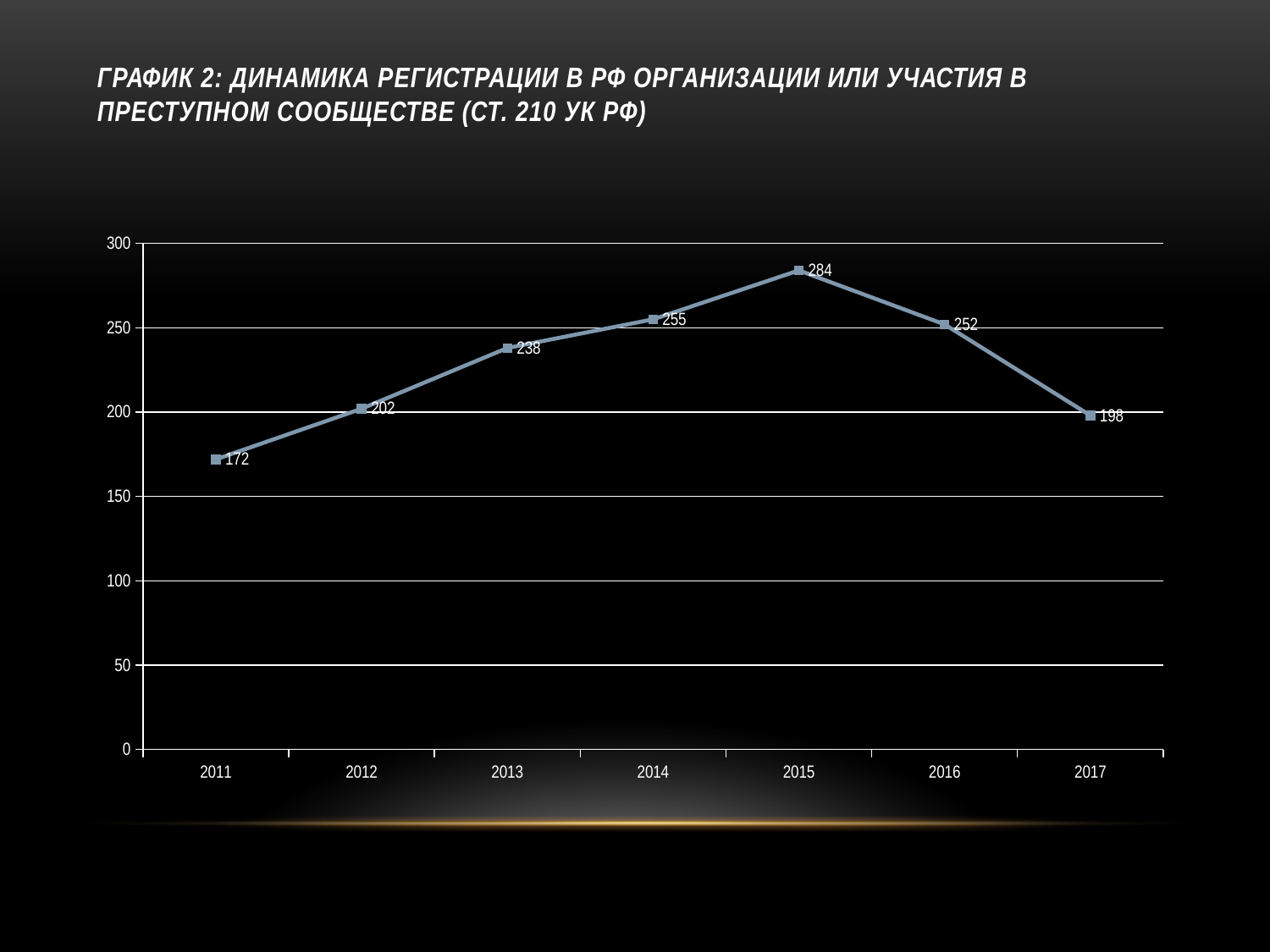
What is the difference between the values for 2013 and 2012? 36 What kind of chart is shown on the slide? line chart Is the value for 2017 greater or less than 200? less Which year has the highest value? 2015 What is the value for 2015? 284 What is the difference between the values for 2015 and 2016? 32 What is the value for 2017? 198 Do the values rise or fall from 2011 to 2015? rise How many years are plotted on the chart? 7 Which is larger, the value for 2014 or the value for 2016? 2014 Which year has the lowest value? 2011 What is the value for 2011? 172